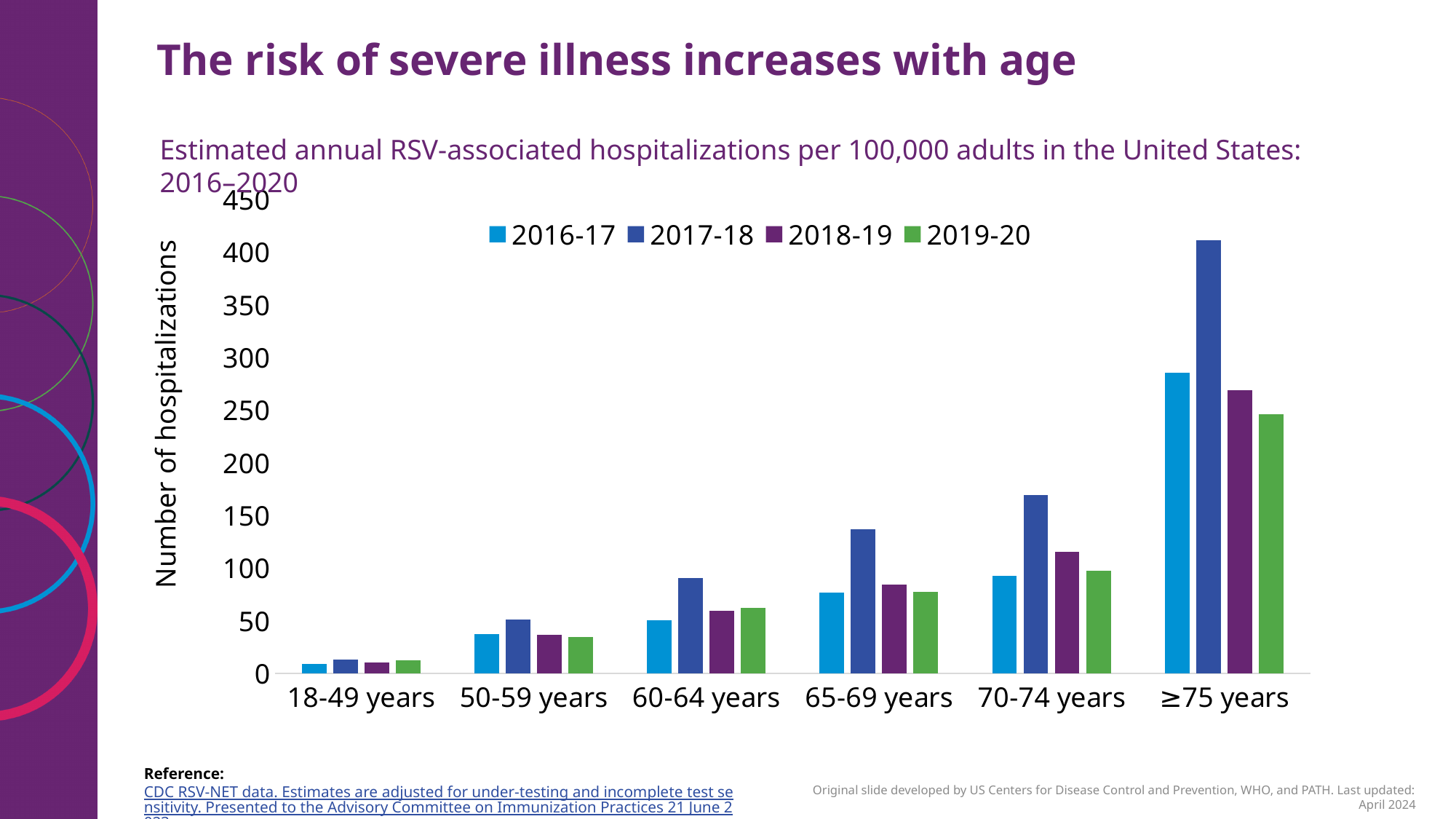
Do the hospitalization values rise or fall as age increases along the x axis? rise What is the title of the y axis? Number of hospitalizations How many series does the legend list? 4 Is the 2017-18 value for 70-74 years greater or less than 150? greater Which age group has the highest value for the 2017-18 series? ≥75 years Is the 2017-18 value for ≥75 years greater or less than 400? greater What kind of chart is shown on the slide? bar chart Is the 2019-20 value for 65-69 years greater or less than 100? less How many age groups are shown on the x axis? 6 Which age group has the lowest value for the 2017-18 series? 18-49 years For the ≥75 years group, which series has the larger value, 2017-18 or 2019-20? 2017-18